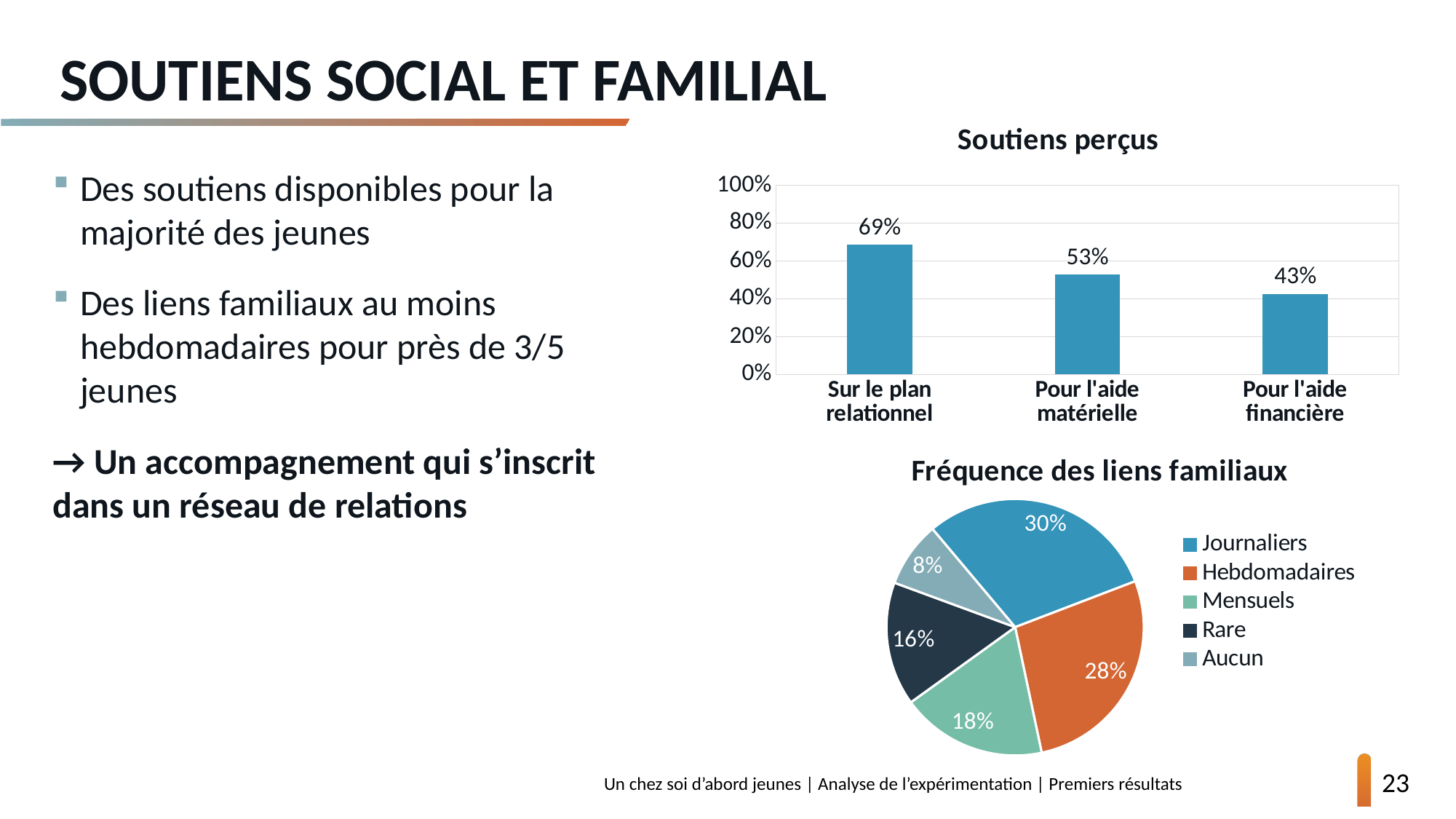
In the 'Fréquence des liens familiaux' chart, which is larger, 'Mensuels' or 'Rare'? Mensuels What kind of chart is 'Soutiens perçus'? Bar chart In the 'Fréquence des liens familiaux' chart, what share is 'Hebdomadaires'? 28% In the 'Fréquence des liens familiaux' chart, which category has the smallest slice? Aucun In the 'Soutiens perçus' chart, what is the difference between 'Sur le plan relationnel' and 'Pour l'aide matérielle'? 16% In the 'Soutiens perçus' chart, how many categories are shown? 3 How many entries does the legend of the 'Fréquence des liens familiaux' chart list? 5 In the 'Soutiens perçus' chart, which category has the highest value? Sur le plan relationnel In the 'Soutiens perçus' chart, which category has the lowest value? Pour l'aide financière In the 'Soutiens perçus' chart, what is the value for 'Pour l'aide financière'? 43% In the 'Soutiens perçus' chart, what is the value for 'Sur le plan relationnel'? 69% In the 'Soutiens perçus' chart, do the values rise or fall from left to right? Fall